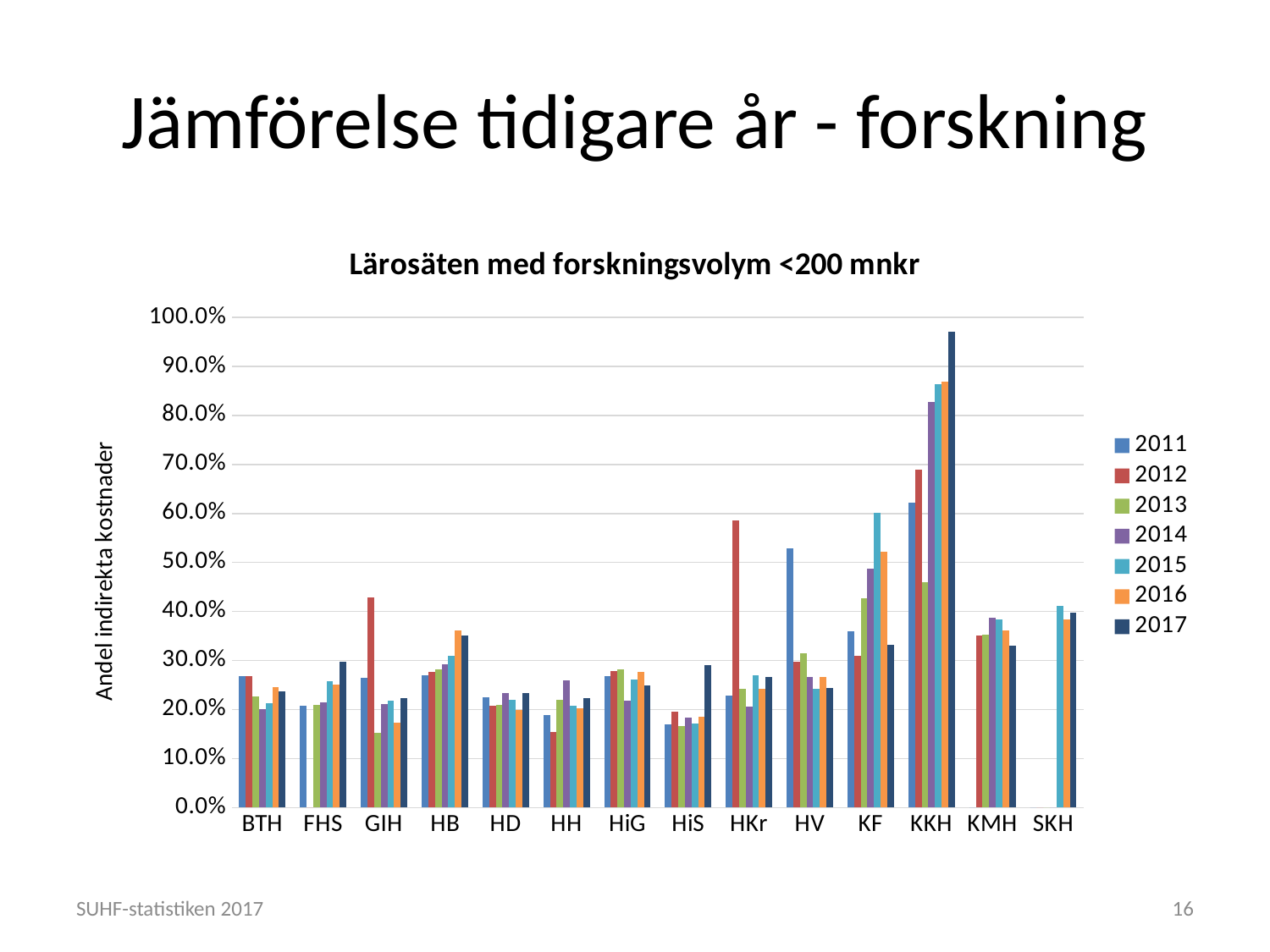
What is the label on the vertical axis? Andel indirekta kostnader How many categories are shown on the x axis? 14 What is the title of the chart? Lärosäten med forskningsvolym <200 mnkr Which category has the highest 2017 value? KKH Is the 2012 value for HKr greater or less than 50.0%? greater For HV, which is larger: the 2011 value or the 2012 value? 2011 Which category has the highest 2012 value? KKH What kind of chart is shown on the slide? bar chart How many series does the legend list? 7 Is the 2012 value for HH greater or less than 20.0%? less Is the 2012 value for GIH greater or less than 40.0%? greater